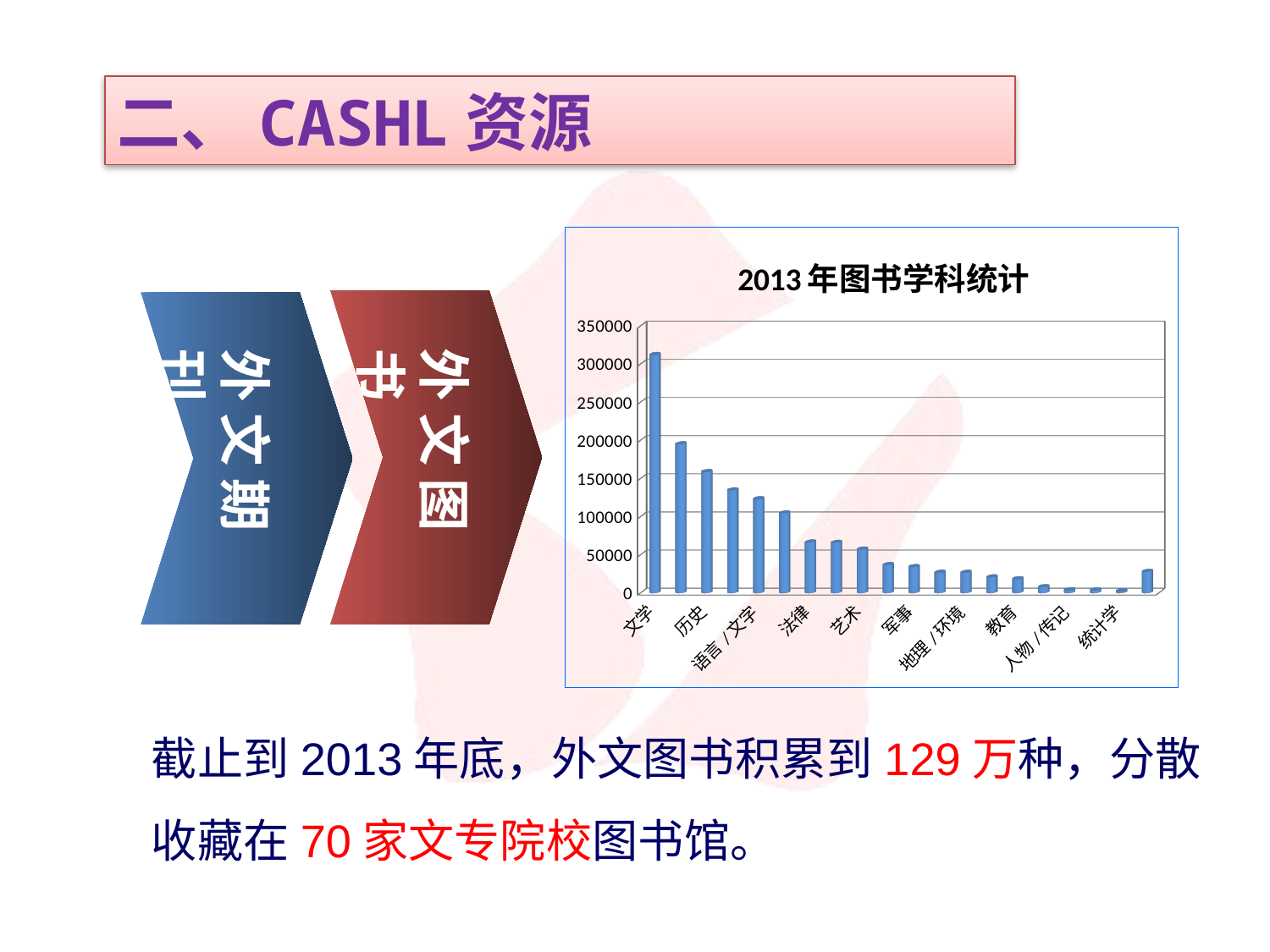
Is the value for 历史 greater or less than 200000? less What is the highest value shown on the vertical axis of the chart? 350000 What is the title of the chart? 2013年图书学科统计 Which category has the highest value in the chart? 文学 What kind of chart is shown on the slide? bar chart Is the value for 语言/文字 greater or less than 100000? greater Do the bar values generally rise or fall from left to right across the chart? fall Which is larger, the value for 文学 or the value for 历史? 文学 Which is larger, the value for 历史 or the value for 语言/文字? 历史 Is the value for 法律 greater or less than 100000? less